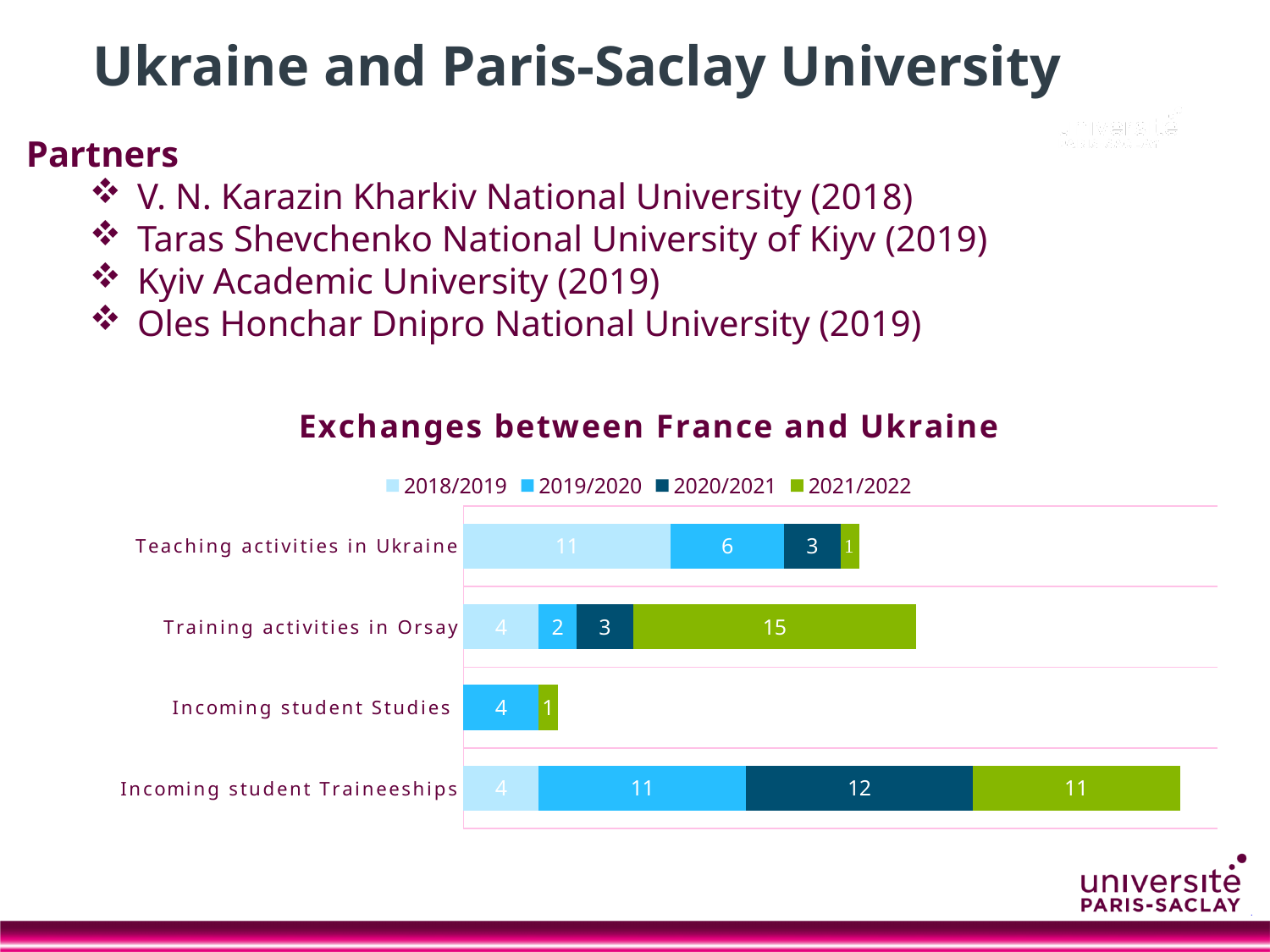
What is the 2018/2019 value for 'Teaching activities in Ukraine'? 11 What is the 2021/2022 value for 'Training activities in Orsay'? 15 Which is larger: the 2019/2020 value for 'Incoming student Traineeships' or the 2019/2020 value for 'Teaching activities in Ukraine'? Incoming student Traineeships Which category has the lowest total in the 'Exchanges between France and Ukraine' chart? Incoming student Studies What kind of chart is shown under the title 'Exchanges between France and Ukraine'? Stacked bar chart What is the difference between the 2021/2022 value for 'Training activities in Orsay' and the 2021/2022 value for 'Teaching activities in Ukraine'? 14 What is the total of the stacked bar for 'Teaching activities in Ukraine'? 21 What is the total of the stacked bar for 'Incoming student Studies'? 5 How many categories are plotted in the 'Exchanges between France and Ukraine' chart? 4 What is the total of the stacked bar for 'Incoming student Traineeships'? 38 How many series does the legend of the 'Exchanges between France and Ukraine' chart list? 4 What is the 2020/2021 value for 'Incoming student Traineeships'? 12